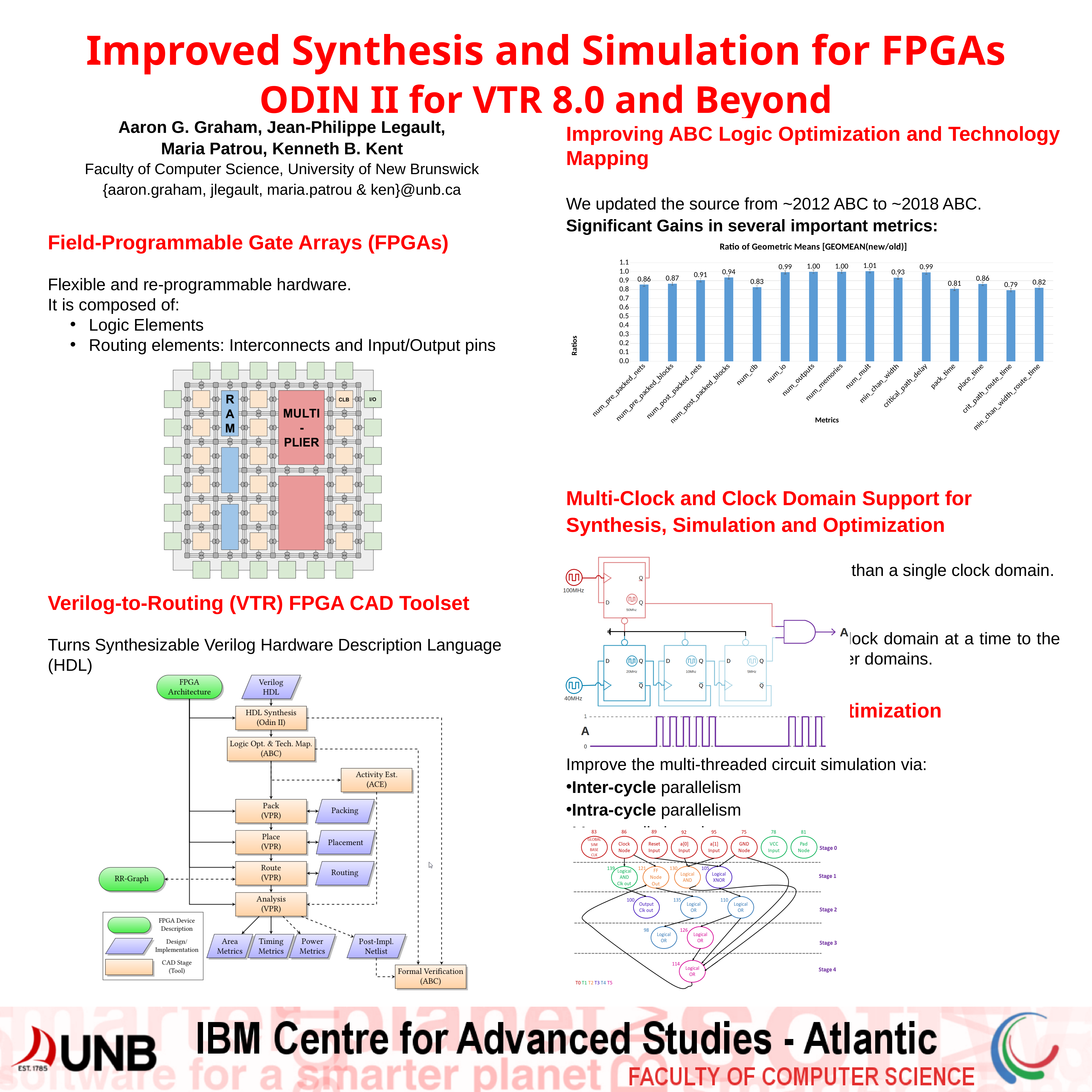
In the 'Ratio of Geometric Means' chart, what is the label of the x axis? Metrics In the 'Ratio of Geometric Means' chart, what is the label of the y axis? Ratios How many metrics are plotted in the 'Ratio of Geometric Means' chart? 15 In the 'Ratio of Geometric Means' chart, what is the value for num_mult? 1.01 In the 'Ratio of Geometric Means' chart, what is the difference between the values for num_post_packed_blocks and num_pre_packed_nets? 0.08 In the 'Ratio of Geometric Means' chart, which metric has the lowest ratio? crit_path_route_time What type of chart is the 'Ratio of Geometric Means [GEOMEAN(new/old)]' chart? bar chart In the 'Ratio of Geometric Means' chart, which metric has the highest ratio? num_mult In the 'Ratio of Geometric Means' chart, what is the value for num_clb? 0.83 In the 'Ratio of Geometric Means' chart, which is larger: the value for num_io or the value for place_time? num_io In the 'Ratio of Geometric Means' chart, what is the value for pack_time? 0.81 In the 'Ratio of Geometric Means' chart, what is the value for min_chan_width? 0.93